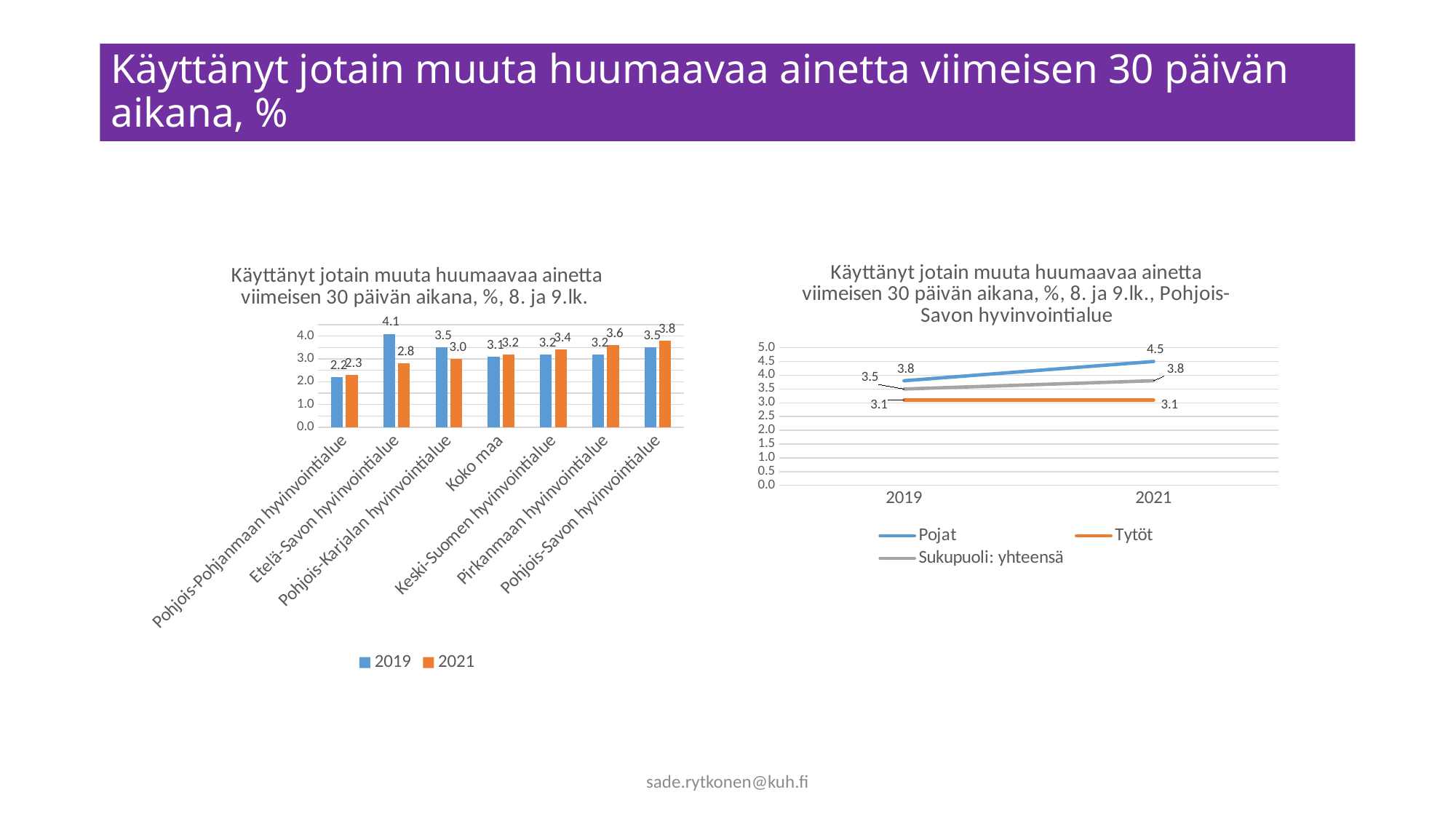
In the left bar chart, what is the difference between the 2019 and 2021 values for Etelä-Savon hyvinvointialue? 1.3 In the left bar chart, is the 2019 value for Koko maa larger or smaller than its 2021 value? smaller In the right line chart, how does the Pojat line change from 2019 to 2021? rises How many categories are shown on the x axis of the left bar chart? 7 In the left bar chart, which category has the lowest 2019 value? Pohjois-Pohjanmaan hyvinvointialue How many series does the legend of the right line chart list? 3 In the right line chart, what is the value for Pojat in 2021? 4.5 In the left bar chart, what is the 2021 value for Pohjois-Savon hyvinvointialue? 3.8 In the left bar chart, what is the 2019 value for Etelä-Savon hyvinvointialue? 4.1 In the left bar chart, which category has the highest 2021 value? Pohjois-Savon hyvinvointialue In the right line chart, what is the difference between the Pojat and Tytöt values in 2021? 1.4 What type of chart is the chart on the left of the slide? bar chart